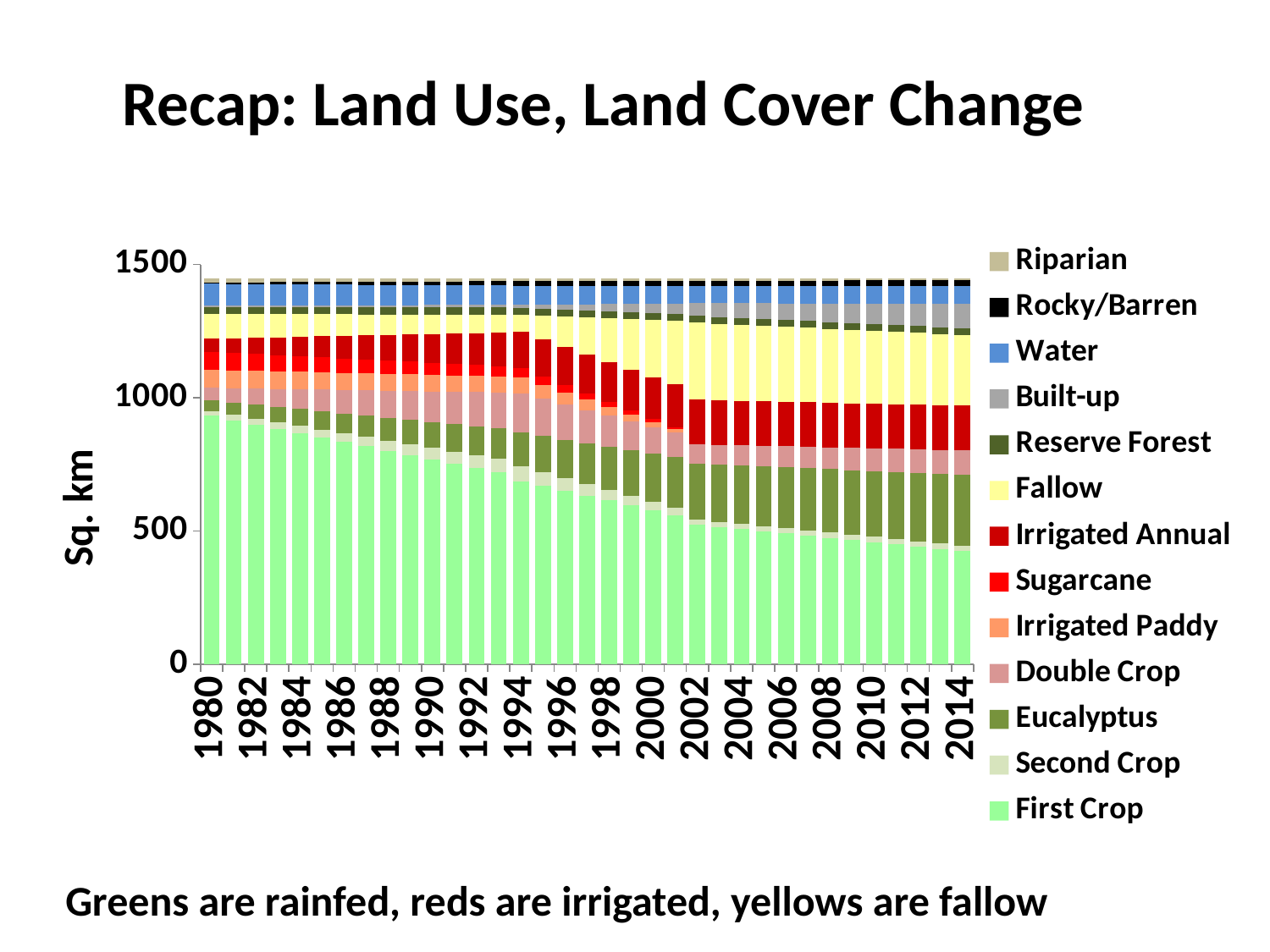
Is the First Crop value in 1980 greater or less than 500? greater Does the Fallow area rise or fall from 1980 to 2014? Rise How many series does the legend list? 13 Which legend entry is listed first, at the top of the legend? Riparian Does the First Crop area rise or fall from 1980 to 2014? Fall Which year has the larger First Crop area, 1980 or 2014? 1980 What kind of chart is shown on the slide? Stacked bar chart What is the label on the y axis? Sq. km Is the total height of the 1980 bar greater or less than 1000? greater What is the last year shown on the x axis? 2014 What is the first year shown on the x axis? 1980 Is the First Crop value in 2014 greater or less than 500? less